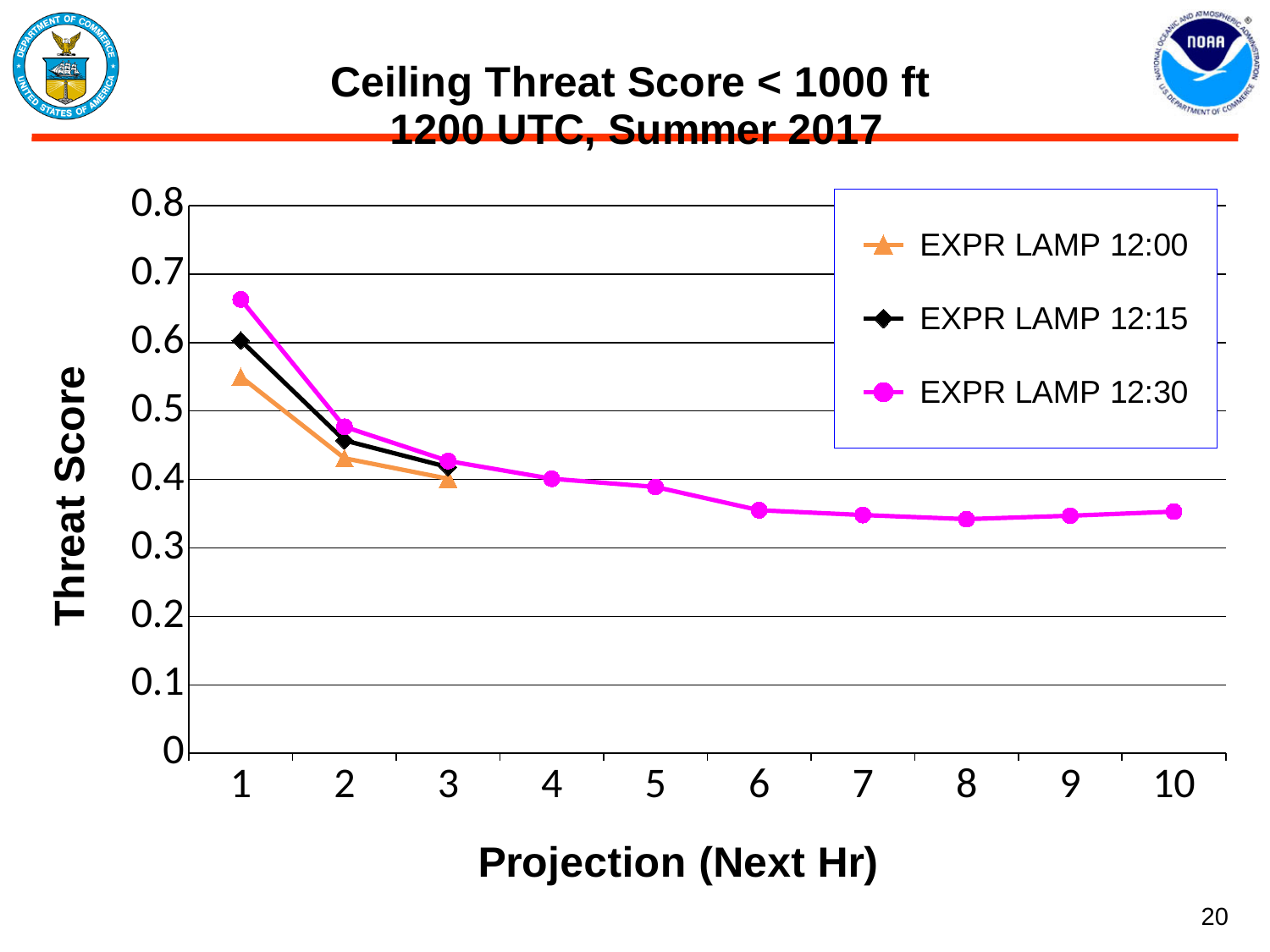
What are the three series named in the legend? EXPR LAMP 12:00, EXPR LAMP 12:15, EXPR LAMP 12:30 What is the title of the y axis? Threat Score What kind of chart is shown on the slide? line chart Is the value for EXPR LAMP 12:00 at projection 1 greater or less than 0.6? less Is the value for EXPR LAMP 12:30 at projection 8 greater or less than 0.4? less Is the value for EXPR LAMP 12:30 at projection 1 greater or less than 0.6? greater Does the threat score for EXPR LAMP 12:30 rise or fall from projection 1 to projection 8? fall How many data points are plotted for the EXPR LAMP 12:00 series? 3 Which series has the lowest threat score at projection 1? EXPR LAMP 12:00 How many projection hours are shown on the x axis? 10 Which series has the highest threat score at projection 1? EXPR LAMP 12:30 How many series does the legend list? 3